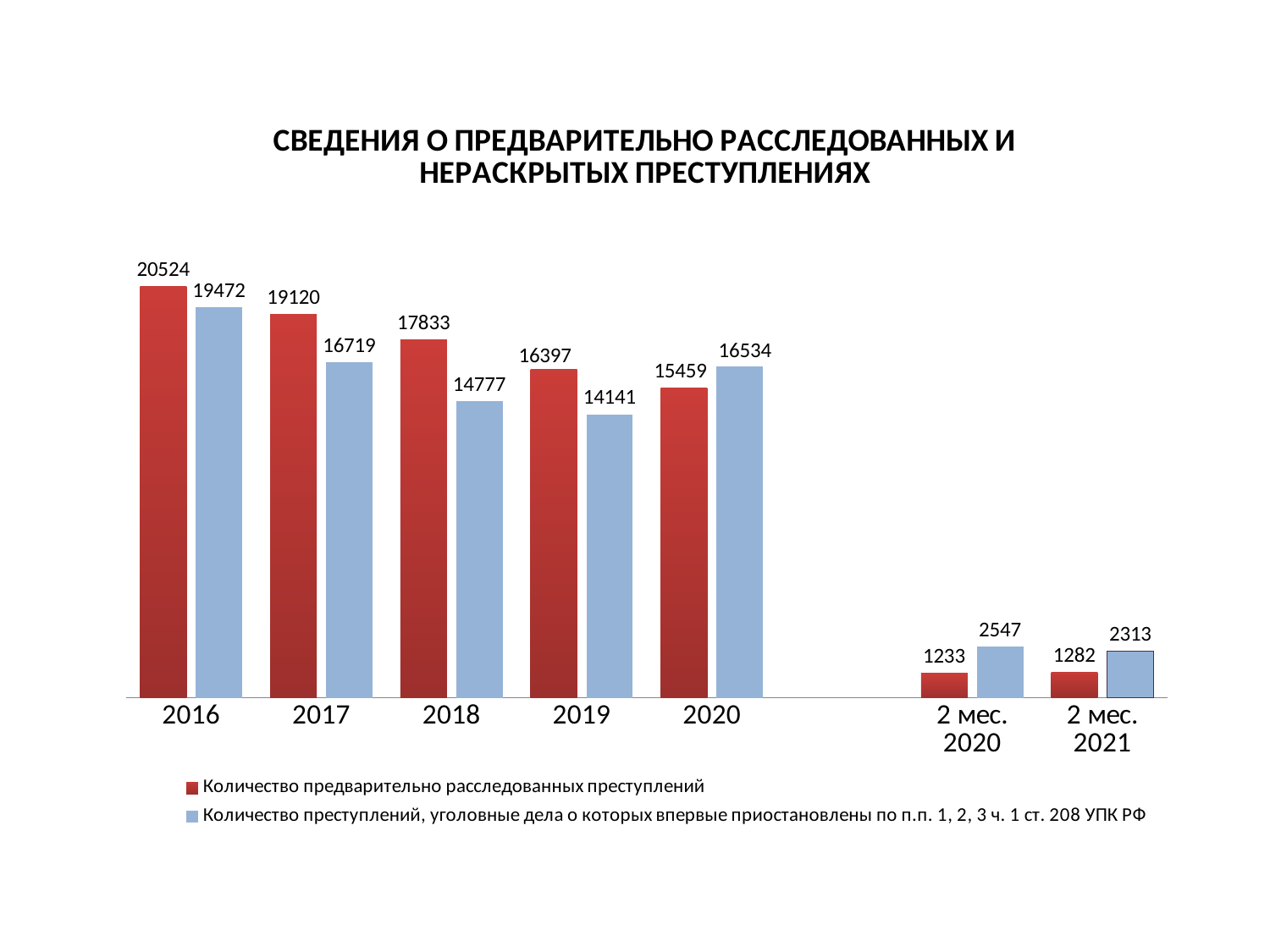
From 2016 to 2020, does the number of preliminarily investigated crimes (red series) rise or fall? Fall What kind of chart is shown on the slide? Bar chart What is the number of preliminarily investigated crimes for 2 мес. 2021? 1282 What is the number of preliminarily investigated crimes (Количество предварительно расследованных преступлений) in 2016? 20524 How many categories are shown on the x axis? 7 What is the difference between the red and blue values in 2018? 3056 In 2020, which is larger: the number of preliminarily investigated crimes or the number of crimes with cases first suspended? Number of crimes with cases first suspended (16534) What is the value of the blue series (crimes with cases first suspended under art. 208 УПК РФ) for 2019? 14141 In which year is the number of preliminarily investigated crimes (red series) the highest? 2016 Among the full years 2016–2020, which year has the lowest value for the blue series (crimes with cases first suspended)? 2019 What colour represents the series 'Количество предварительно расследованных преступлений'? Red How many series does the legend list? 2